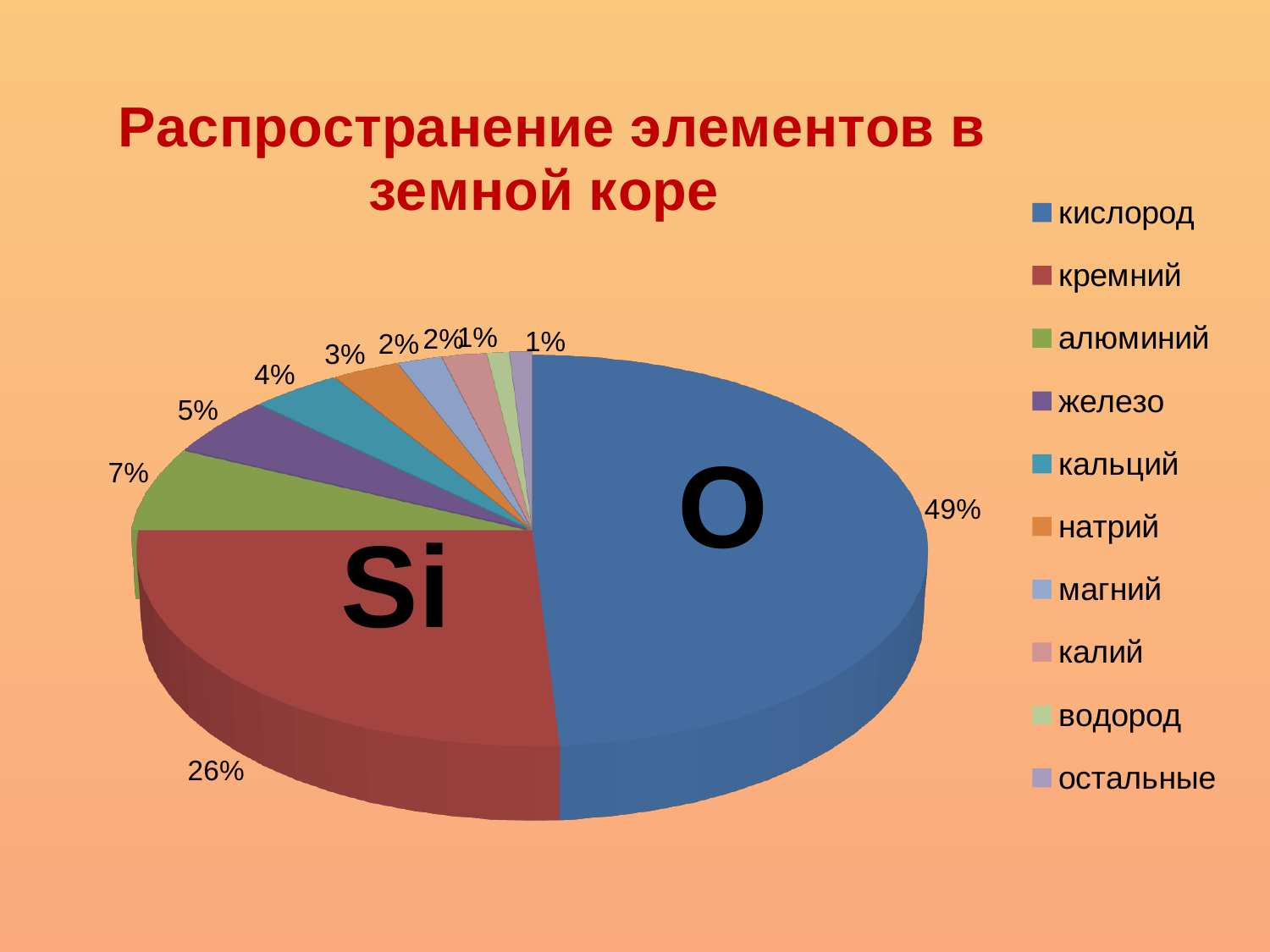
How many entries does the legend list? 10 What is the value shown for алюминий? 7% What is the value shown for кальций? 4% What share of the pie does кислород have? 49% What is the difference between the shares of кислород and кремний? 23% What kind of chart is shown on the slide? pie chart Which is larger, the share of алюминий or the share of натрий? алюминий What is the title of the chart? Распространение элементов в земной коре Which element has the largest slice of the pie? кислород What share of the pie does кремний have? 26% What is the value shown for железо? 5% Which legend entry is shown in blue? кислород